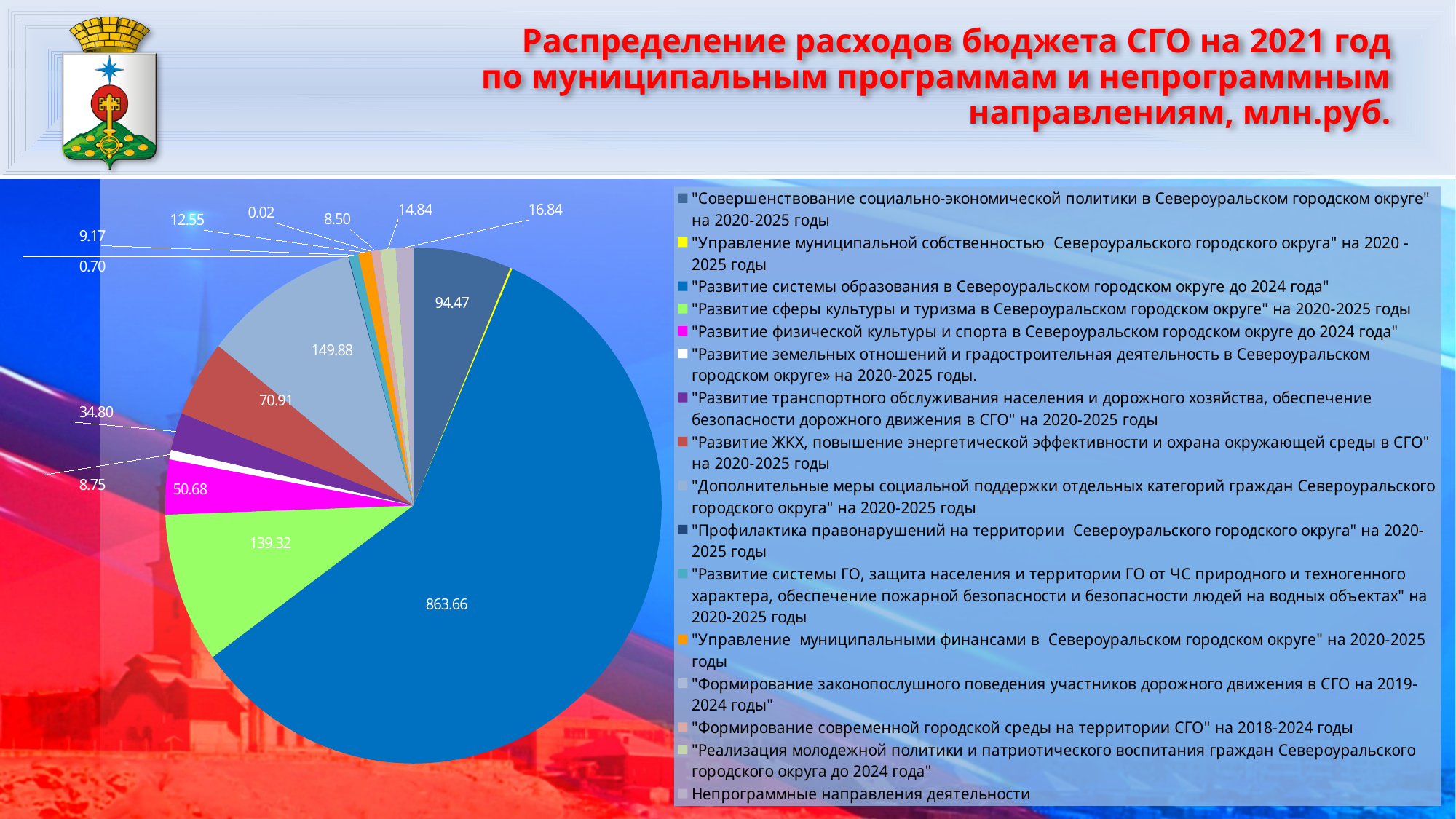
How many entries does the legend of the pie chart list? 16 What is the value shown for "Развитие сферы культуры и туризма в Североуральском городском округе" на 2020-2025 годы? 139.32 What is the value of the largest slice in the pie chart? 863.66 Which programme has the largest share of the 2021 budget expenditure in the pie chart? "Развитие системы образования в Североуральском городском округе до 2024 года" What is the smallest value labelled on the pie chart? 0.02 What is the value shown for "Развитие физической культуры и спорта в Североуральском городском округе до 2024 года"? 50.68 What is the difference between the values for "Развитие системы образования" (863.66) and "Развитие сферы культуры и туризма" (139.32)? 724.34 What is the value shown for "Совершенствование социально-экономической политики в Североуральском городском округе" на 2020-2025 годы? 94.47 What type of chart is shown on the slide? Pie chart What is the value shown for "Развитие ЖКХ, повышение энергетической эффективности и охрана окружающей среды в СГО" на 2020-2025 годы? 70.91 Which is larger: the value for "Дополнительные меры социальной поддержки" or the value for "Развитие сферы культуры и туризма"? "Дополнительные меры социальной поддержки" (149.88) What is the value shown for "Дополнительные меры социальной поддержки отдельных категорий граждан Североуральского городского округа" на 2020-2025 годы? 149.88